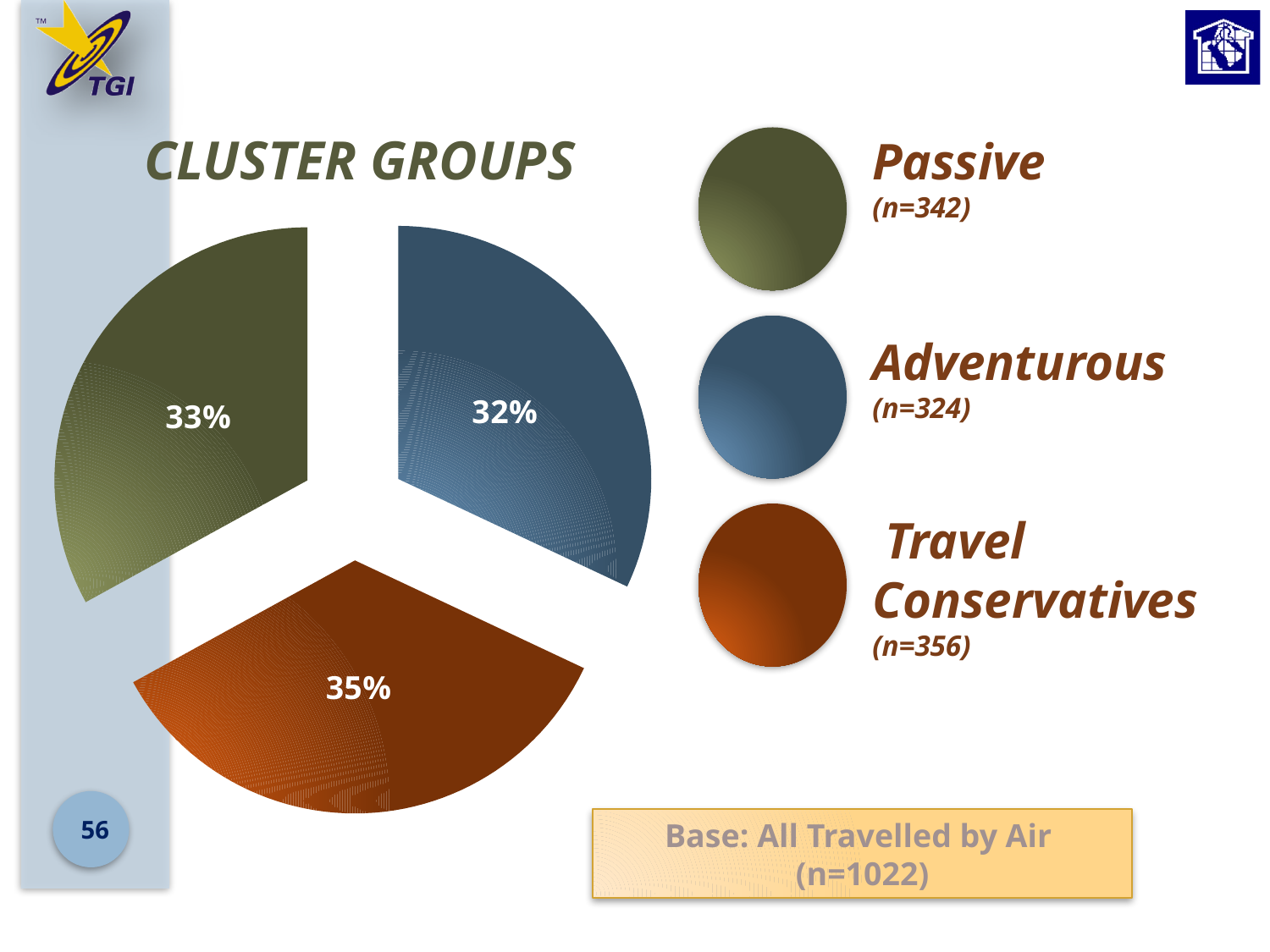
What kind of chart is shown on the slide? Pie chart What share of the pie does the Travel Conservatives cluster group represent? 35% Which has a larger share of the pie, Passive or Travel Conservatives? Travel Conservatives What share of the pie does the Adventurous cluster group represent? 32% What is the title of the chart? CLUSTER GROUPS What is the difference in percentage points between the Passive share and the Adventurous share? 1 percentage point How many cluster groups are shown in the pie chart? 3 Which cluster group has the smallest share of the pie? Adventurous What share of the pie does the Passive cluster group represent? 33% What is the difference in percentage points between the Travel Conservatives share and the Adventurous share? 3 percentage points What colour is the slice representing the Adventurous cluster group? Blue Which cluster group has the largest share of the pie? Travel Conservatives